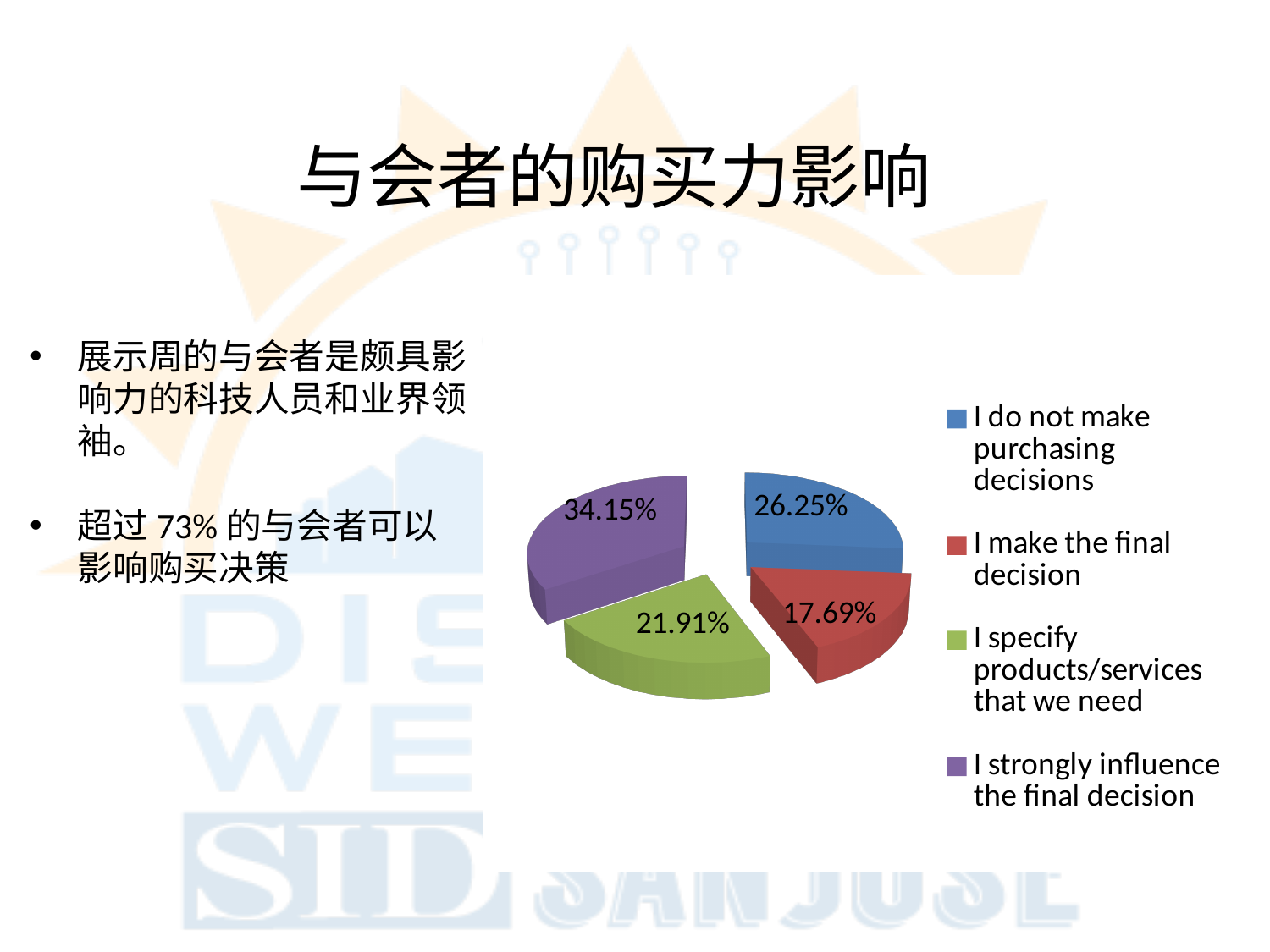
Which category has the largest share of the pie? I strongly influence the final decision What percentage of attendees say "I specify products/services that we need"? 21.91% What colour is the slice for "I specify products/services that we need"? Green What percentage of attendees say "I do not make purchasing decisions"? 26.25% Which category has the smallest share of the pie? I make the final decision How many slices does the pie chart have? 4 What kind of chart is shown on the slide? Pie chart How many entries does the legend list? 4 Which is larger: the share for "I do not make purchasing decisions" or the share for "I specify products/services that we need"? I do not make purchasing decisions What is the difference between the share for "I strongly influence the final decision" and the share for "I make the final decision"? 16.46% What percentage of attendees say "I make the final decision"? 17.69% What percentage of attendees say "I strongly influence the final decision"? 34.15%